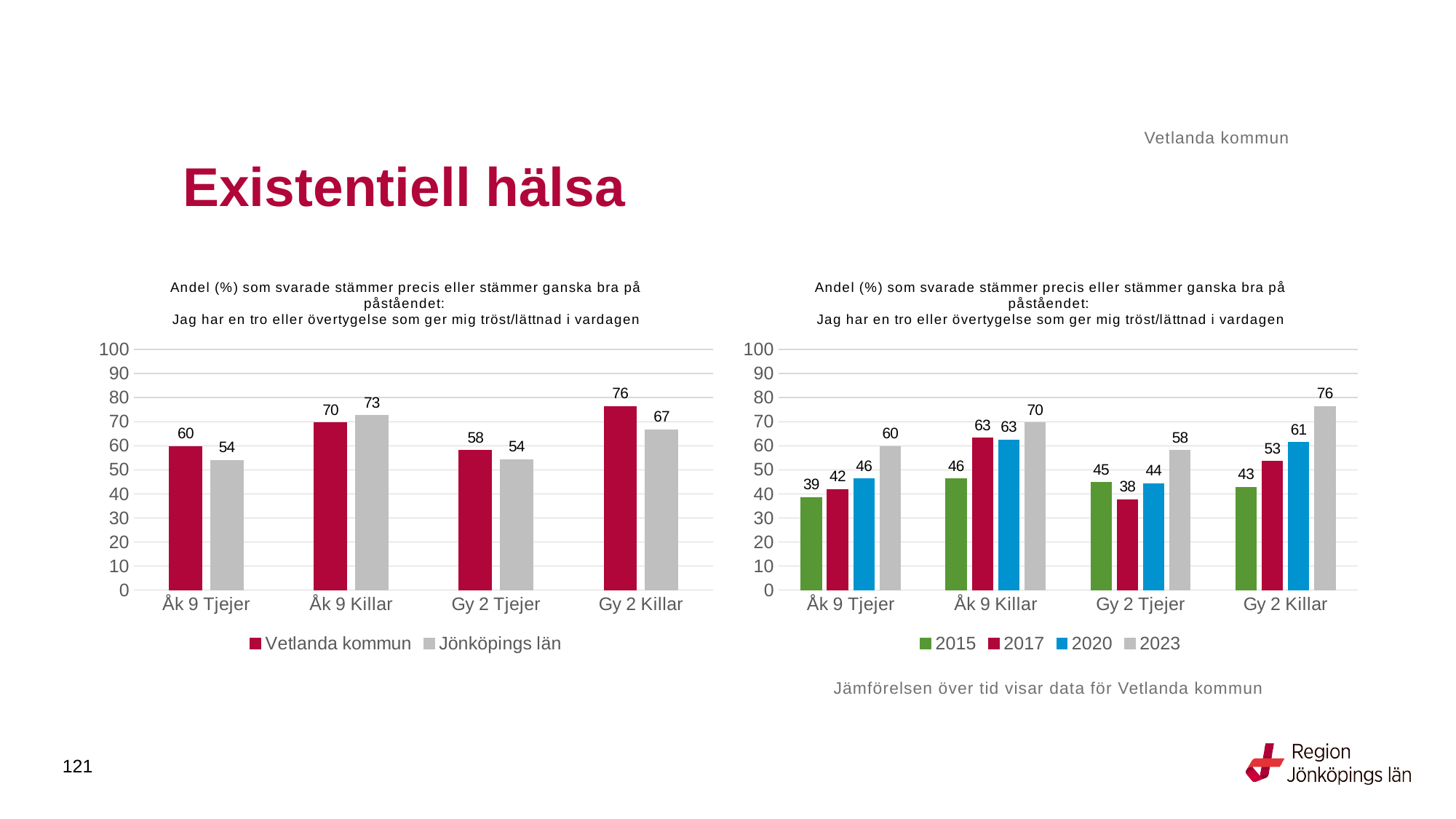
In the left chart, what is the value for Jönköpings län for Gy 2 Killar? 67 In the right chart, which category has the lowest value for 2015? Åk 9 Tjejer In the right chart, what is the difference between 2023 and 2015 for Gy 2 Killar? 33 In the right chart, do the values for Åk 9 Tjejer rise or fall from 2015 to 2023? rise How many series does the legend of the left chart list? 2 In the left chart, which category has the highest value for Vetlanda kommun? Gy 2 Killar In the left chart, what is the value for Vetlanda kommun for Åk 9 Tjejer? 60 What kind of chart is the right chart? bar chart In the right chart, what is the value for 2020 for Gy 2 Killar? 61 In the left chart, what is the difference between Vetlanda kommun and Jönköpings län for Gy 2 Killar? 9 In the left chart, which is larger for Åk 9 Killar: Vetlanda kommun or Jönköpings län? Jönköpings län In the right chart, what is the value for 2017 for Gy 2 Tjejer? 38